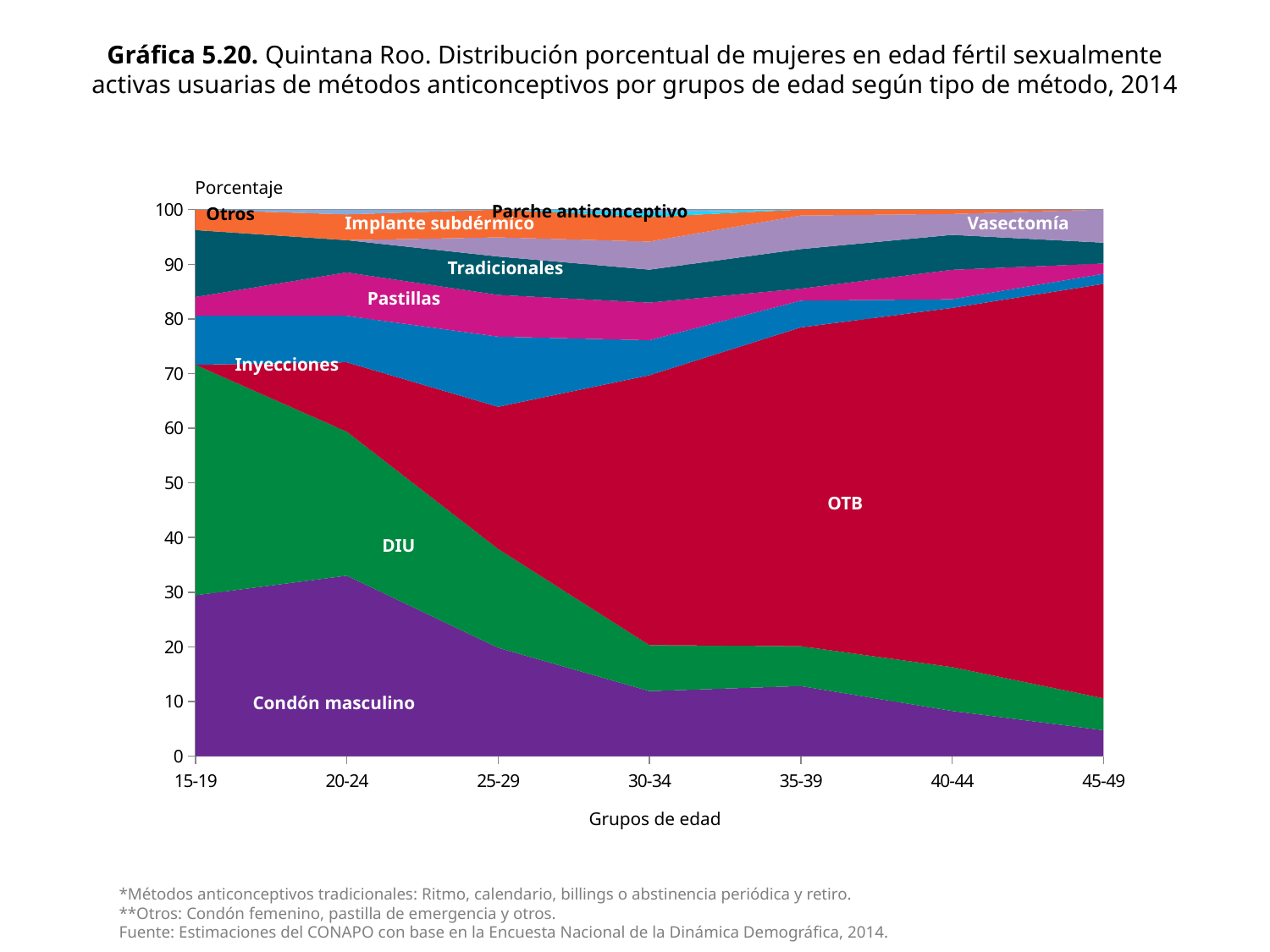
What is the label of the x axis? Grupos de edad What is the label of the y axis? Porcentaje How many age groups are shown along the x axis? 7 Does the share for OTB rise or fall as the age groups increase from 15-19 to 45-49? rise Which age group has the largest share for DIU? 15-19 In the 15-19 age group, which has the larger share: DIU or Condón masculino? DIU Is the share for Condón masculino in the 45-49 age group greater or less than 10? less What kind of chart is shown on the slide? Stacked area chart Which age group has the largest share for OTB? 45-49 Which age group has the smallest share for Condón masculino? 45-49 How many contraceptive method types are labelled on the chart? 10 Is the cumulative top of the OTB band in the 45-49 age group greater or less than 80? greater